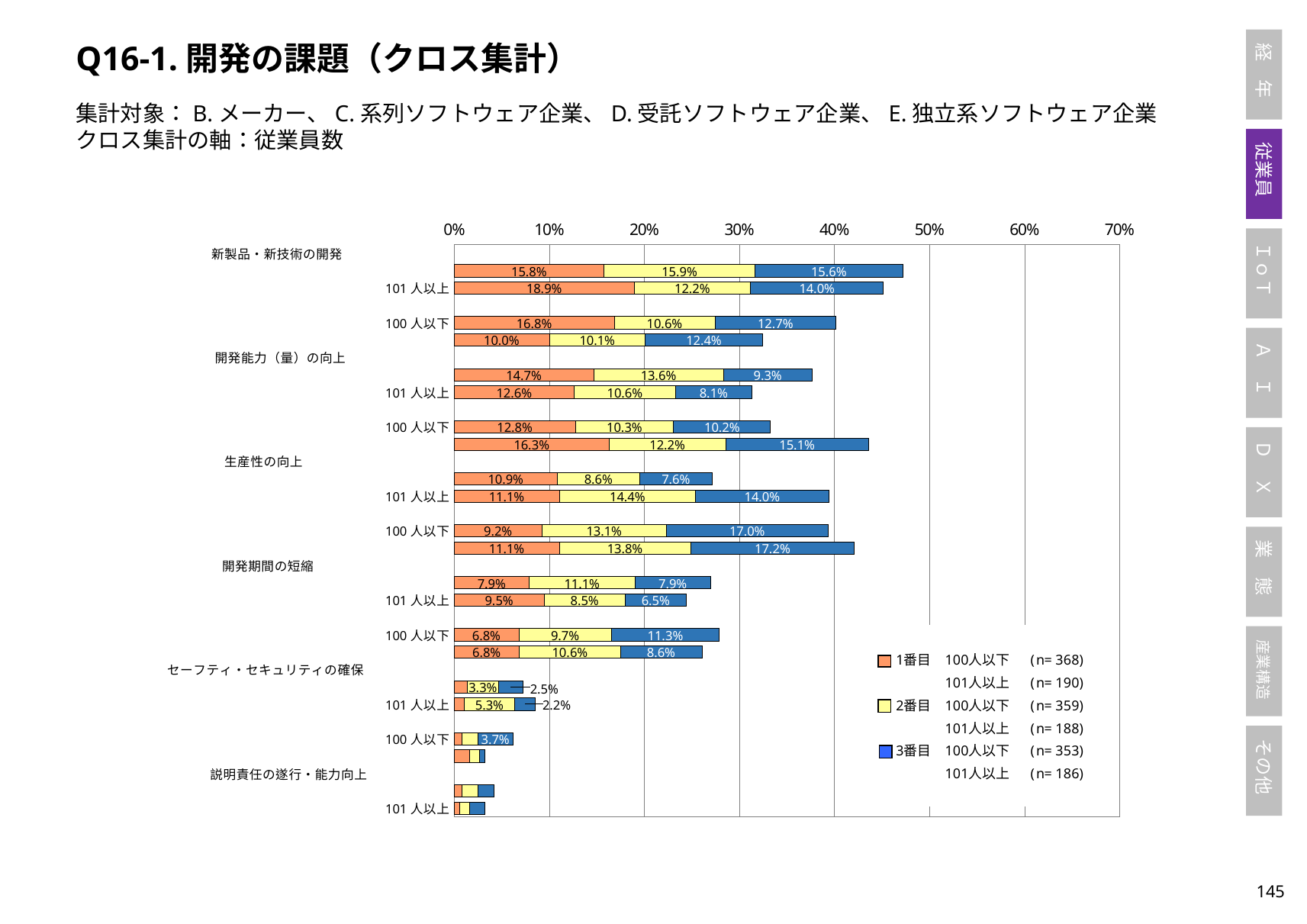
What is the difference between the 1番目 and 2番目 values in the 101人以上 bar for 新製品・新技術の開発? 6.7% What is the total of the 101人以上 stacked bar for 開発期間の短縮? 24.5% In the 101人以上 bar for 開発能力（量）の向上, which is larger, the 1番目 value or the 3番目 value? 1番目 What is the total of the 101人以上 stacked bar for 新製品・新技術の開発? 45.1% According to the legend, what is the n for 1番目 101人以上? 190 What kind of chart is shown on the slide? Stacked horizontal bar chart What are the three series names in the legend? 1番目, 2番目, 3番目 How many series does the legend list? 3 What is the 2番目 value for 生産性の向上 in the 101人以上 bar? 14.4% What is the 3番目 value for 開発期間の短縮 in the 101人以上 bar? 6.5% What is the 1番目 value for 新製品・新技術の開発 in the 101人以上 bar? 18.9%